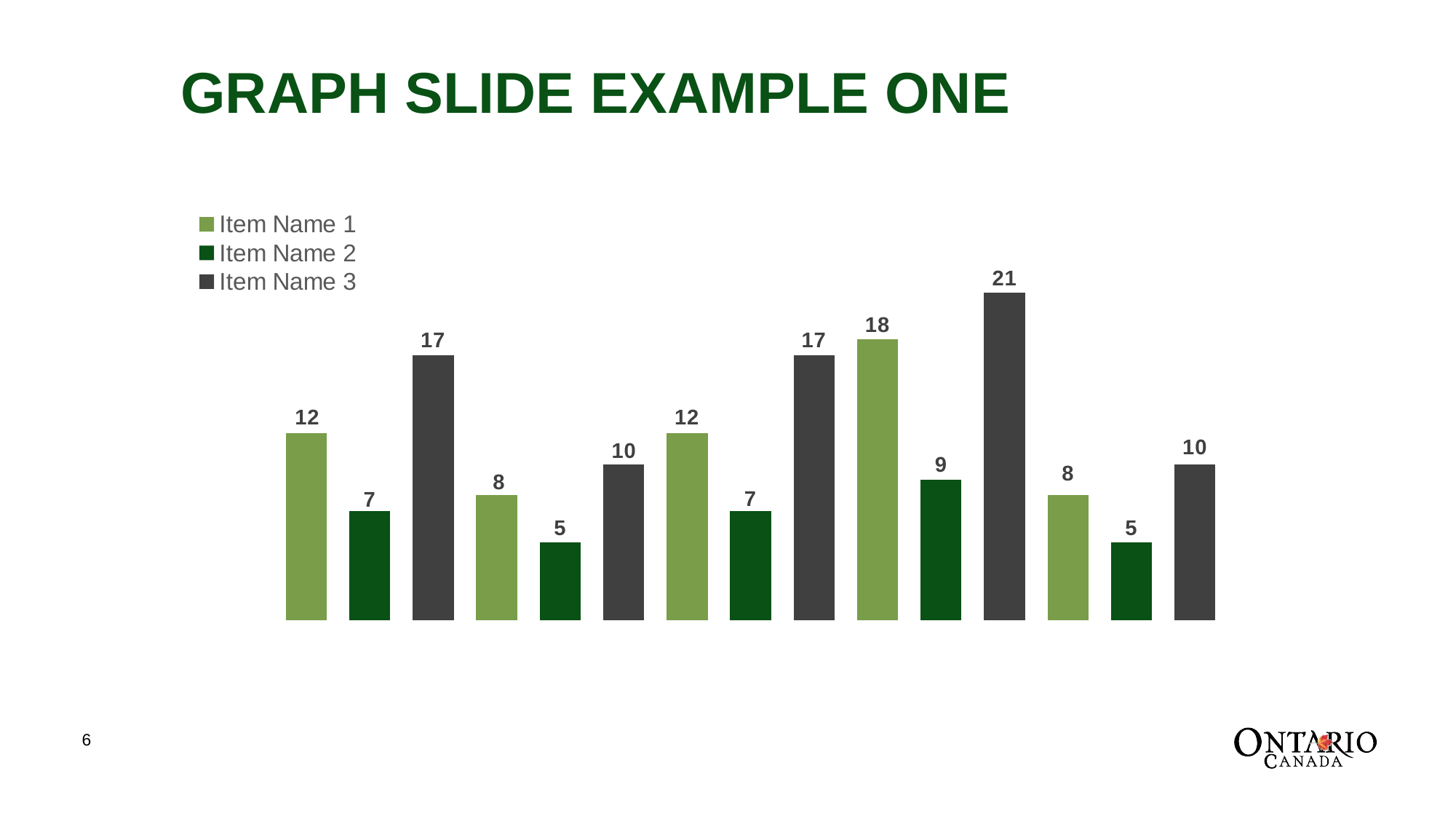
How many bars are plotted in total in the chart? 15 What is the lowest value shown for Item Name 2? 5 What is the title of the slide containing the chart? GRAPH SLIDE EXAMPLE ONE What is the lowest value shown for Item Name 3? 10 Which legend entry is shown in the darkest grey colour? Item Name 3 What is the difference between the highest Item Name 3 value and the highest Item Name 1 value? 3 What is the highest value shown for Item Name 1? 18 What kind of chart is shown on the slide? bar chart How many series does the legend list? 3 What is the highest value shown for Item Name 3? 21 Which series contains the tallest bar in the chart? Item Name 3